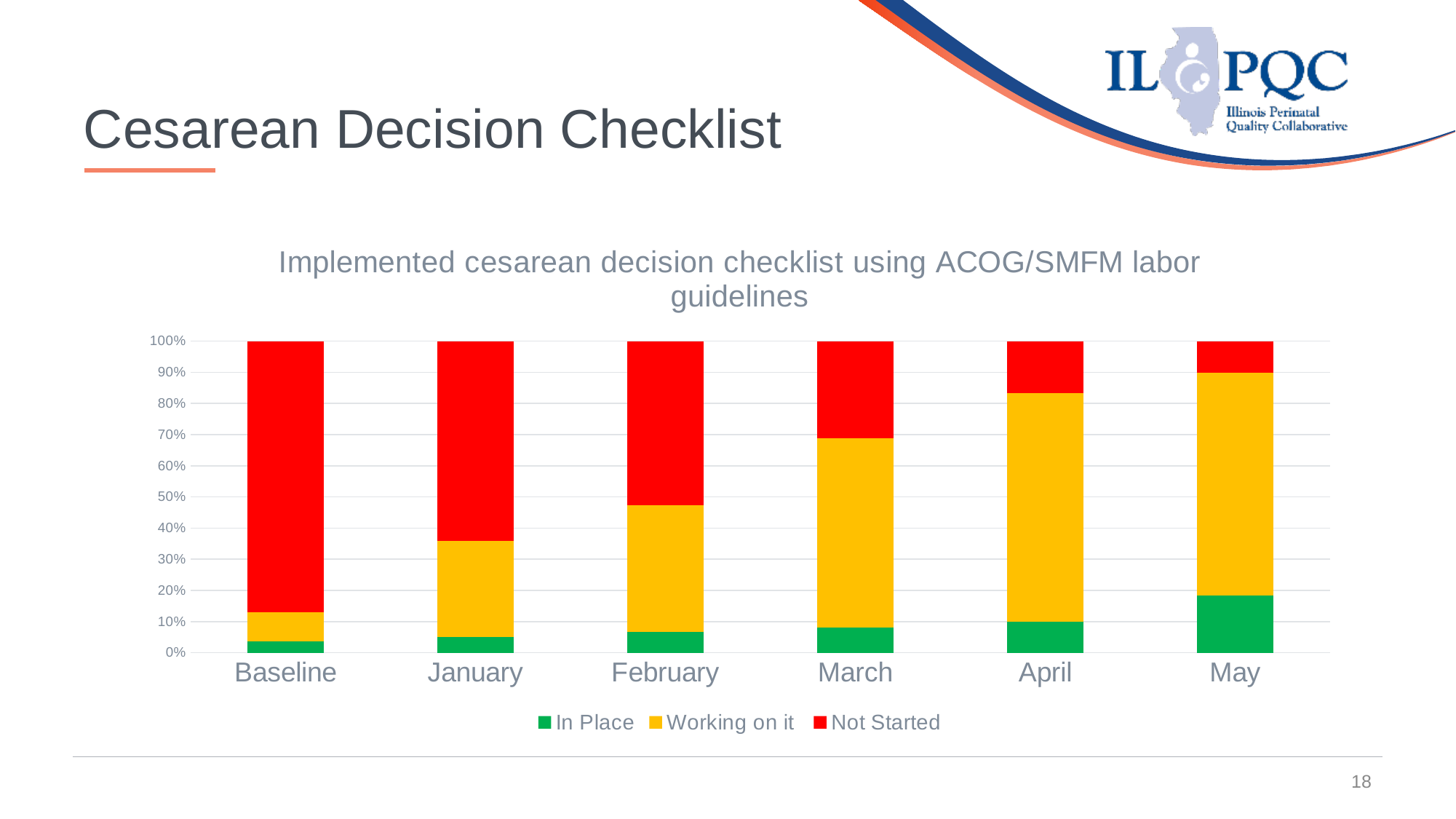
What is the title of the chart? Implemented cesarean decision checklist using ACOG/SMFM labor guidelines Which category has the largest 'Not Started' segment? Baseline Is the 'Not Started' value for Baseline greater or less than 80%? greater Which is larger, the 'Not Started' segment for January or for April? January Is the 'Not Started' value for May greater or less than 20%? less Which category has the largest 'In Place' segment? May How many series does the legend list? 3 Is the 'In Place' value for May greater or less than 10%? greater What kind of chart is shown on the slide? Stacked bar chart Does the 'In Place' share rise or fall from Baseline to May? rise How many categories are shown along the x axis? 6 Which category has the smallest 'Not Started' segment? May